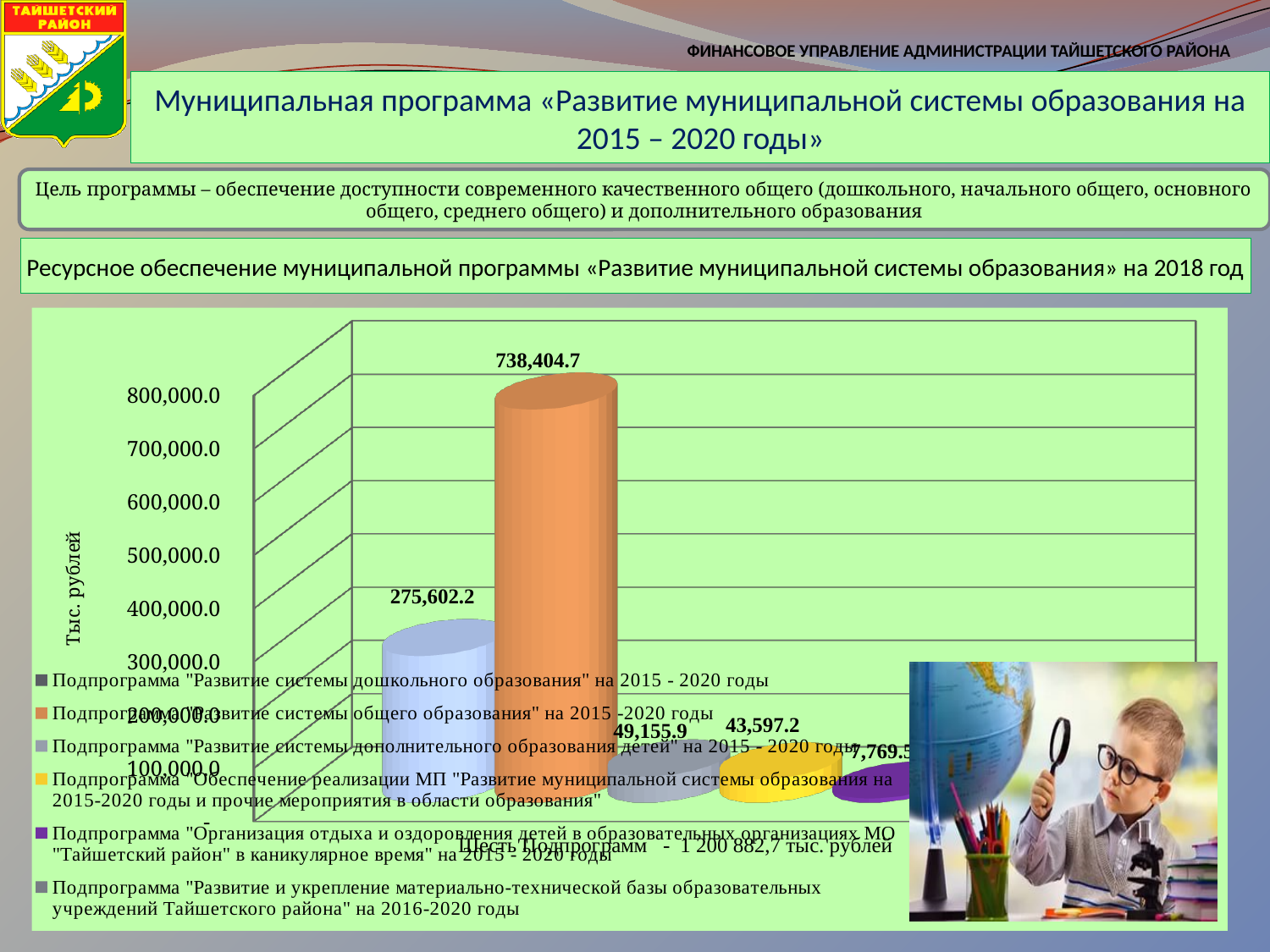
How many series does the legend list? 6 Which is larger: the value for the preschool education subprogram or the value for the additional education subprogram? Preschool education subprogram What is the value for the subprogram "Развитие системы дополнительного образования детей" на 2015-2020 годы? 49,155.9 What is the value for the subprogram "Обеспечение реализации МП «Развитие муниципальной системы образования на 2015-2020 годы» и прочие мероприятия в области образования"? 43,597.2 What is the difference between the values for the general education subprogram (738,404.7) and the preschool education subprogram (275,602.2)? 462,802.5 What is the difference between the values for the additional education subprogram (49,155.9) and the MP implementation subprogram (43,597.2)? 5,558.7 What is the value for the subprogram "Развитие системы общего образования" на 2015-2020 годы? 738,404.7 Which subprogram has the highest value in the chart? Подпрограмма "Развитие системы общего образования" на 2015-2020 годы What is the value for the subprogram "Развитие системы дошкольного образования" на 2015-2020 годы? 275,602.2 Is the value for the general education subprogram greater or less than 700,000.0? greater What kind of chart is shown on the slide? Bar chart What is the label of the vertical axis of the chart? Тыс. рублей